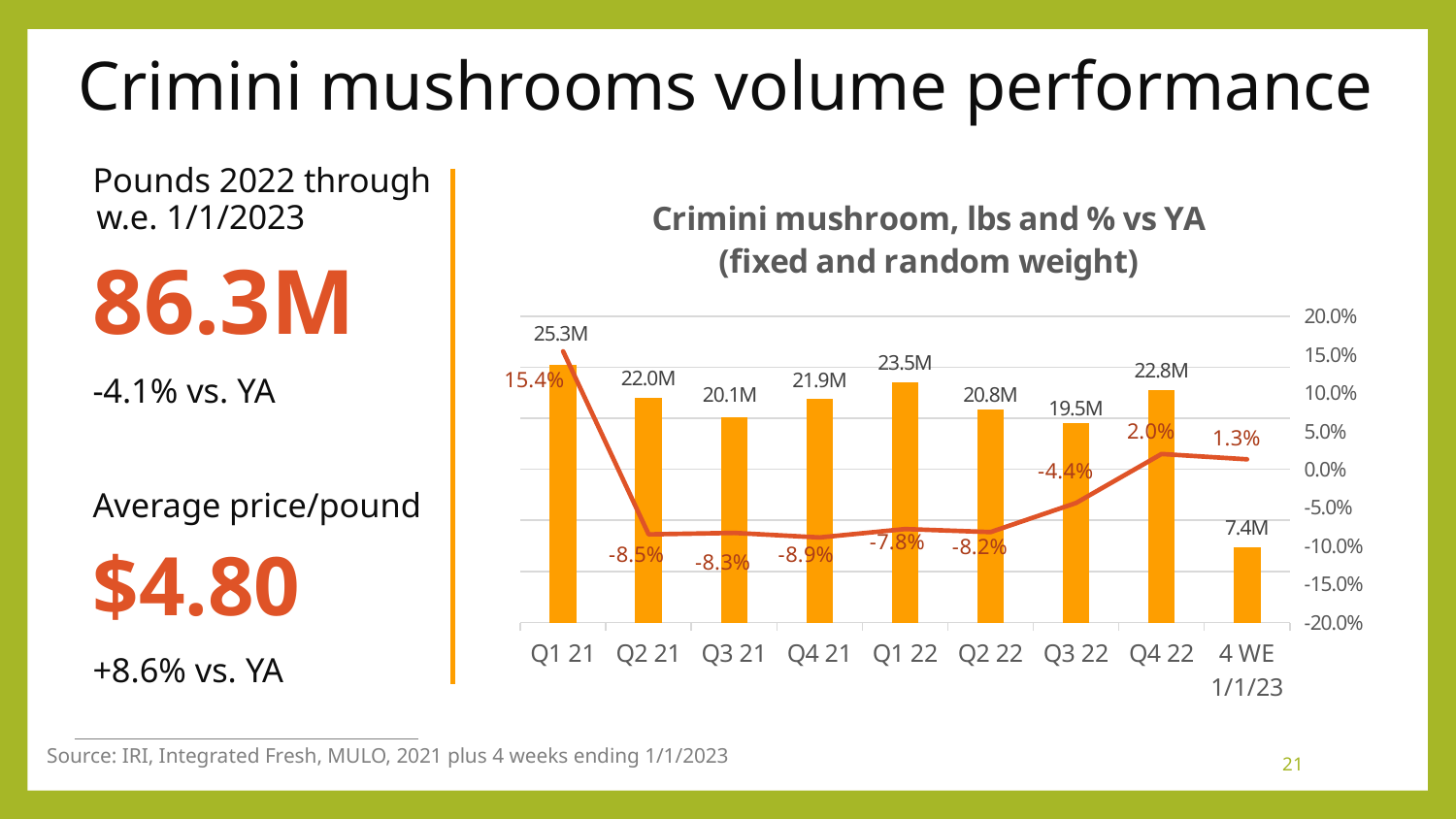
Which has the larger volume in pounds, Q4 21 or Q4 22? Q4 22 What is the volume in pounds for the 4 WE 1/1/23 period? 7.4M What is the difference in pounds between Q1 21 and Q2 21? 3.3M What is the volume in pounds for Q1 22? 23.5M What is the % vs YA value for Q1 21? 15.4% Does the % vs YA line rise or fall from Q3 22 to Q4 22? Rise What kind of chart is this? Combination bar and line chart Which period has the lowest % vs YA value? Q4 21 Which period has the highest volume in pounds? Q1 21 How many periods are shown on the x axis? 9 What is the title of the chart? Crimini mushroom, lbs and % vs YA (fixed and random weight) What is the % vs YA value for Q3 22? -4.4%